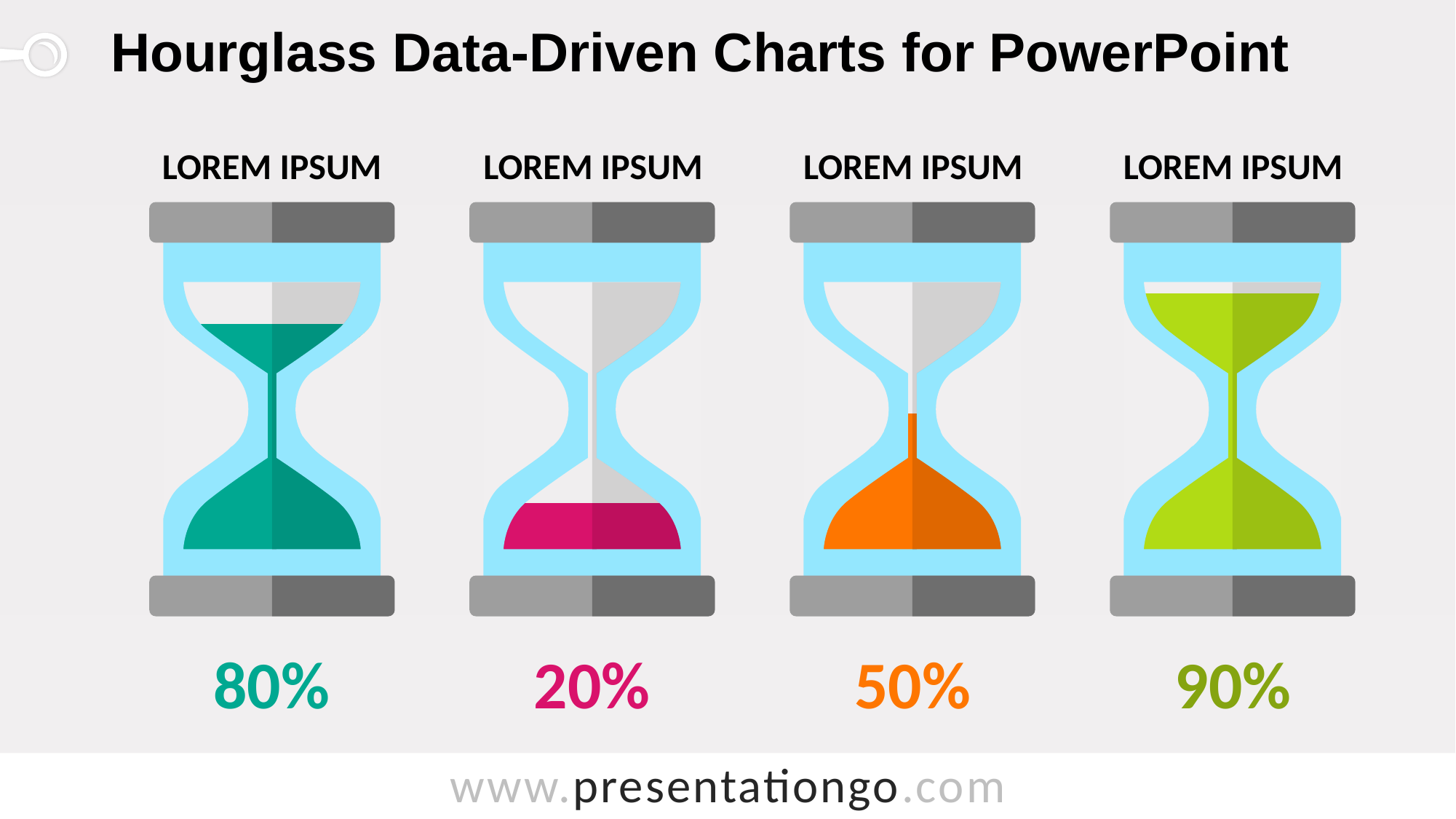
What colour is the fill of the hourglass showing 50%? Orange What is the difference between the value of the teal hourglass and the value of the orange hourglass? 30% Which hourglass shows the highest percentage? The fourth (rightmost, green) hourglass, 90% Which hourglass shows the lowest percentage? The second (pink) hourglass, 20% What value is shown below the fourth (rightmost, green) hourglass? 90% Which is larger, the value of the teal hourglass or the value of the orange hourglass? The teal hourglass (80%) What is the title of the slide? Hourglass Data-Driven Charts for PowerPoint How many hourglass charts are shown on the slide? 4 What value is shown below the third (orange) hourglass? 50% What value is shown below the first (leftmost, teal) hourglass? 80% What value is shown below the second (pink) hourglass? 20% What is the difference between the value of the green hourglass and the value of the pink hourglass? 70%